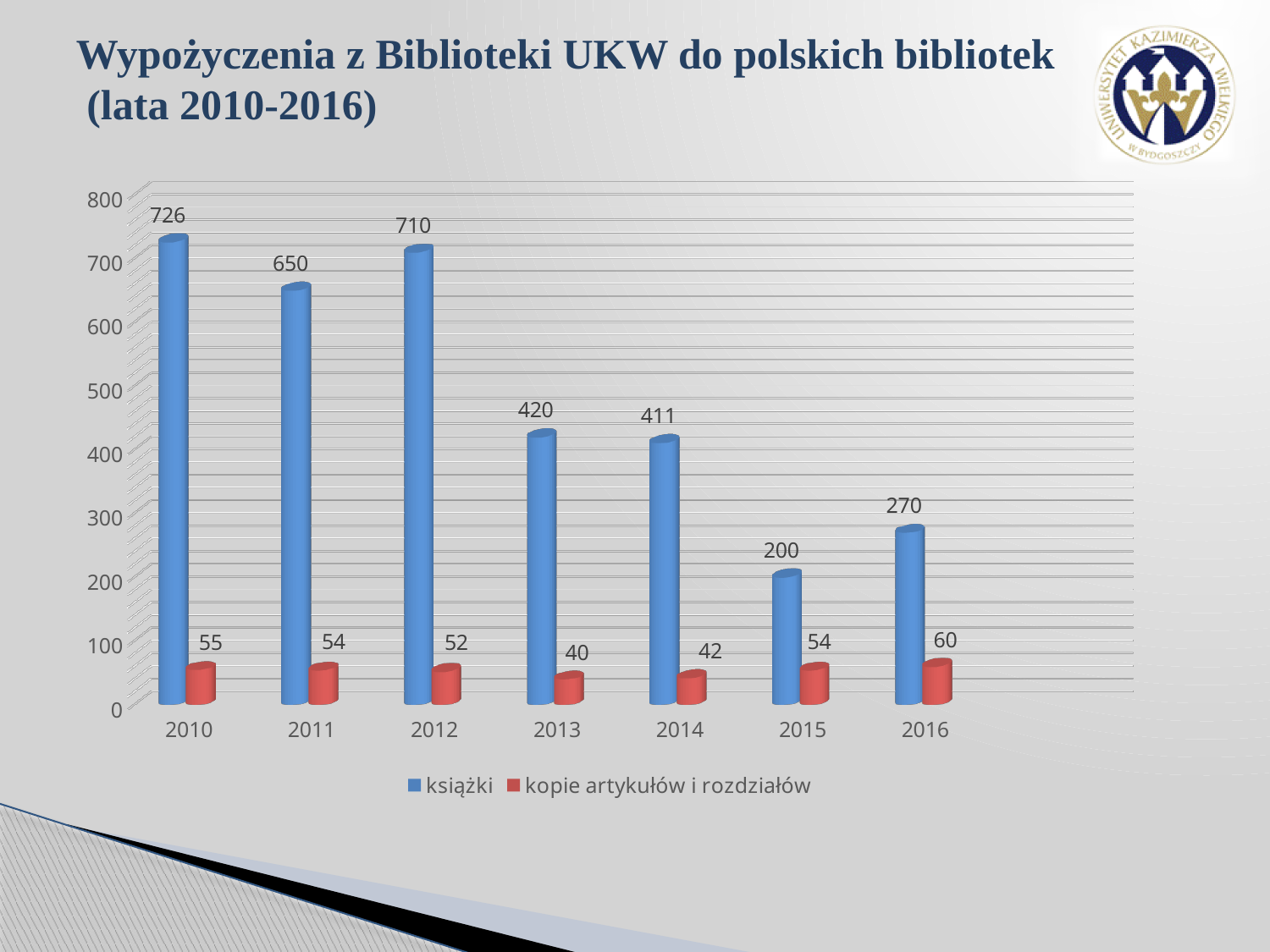
Do the książki values generally rise or fall from 2010 to 2015? fall How many years are shown on the x axis? 7 Which year has the lowest value for książki? 2015 Which is larger, the książki value for 2011 or for 2012? 2012 How many series does the legend list? 2 What is the value for książki in 2010? 726 What is the value for książki in 2016? 270 What is the difference between the książki values for 2012 and 2013? 290 What kind of chart is shown on the slide? bar chart What is the value for kopie artykułów i rozdziałów in 2013? 40 Which year has the highest value for kopie artykułów i rozdziałów? 2016 Which year has the highest value for książki? 2010